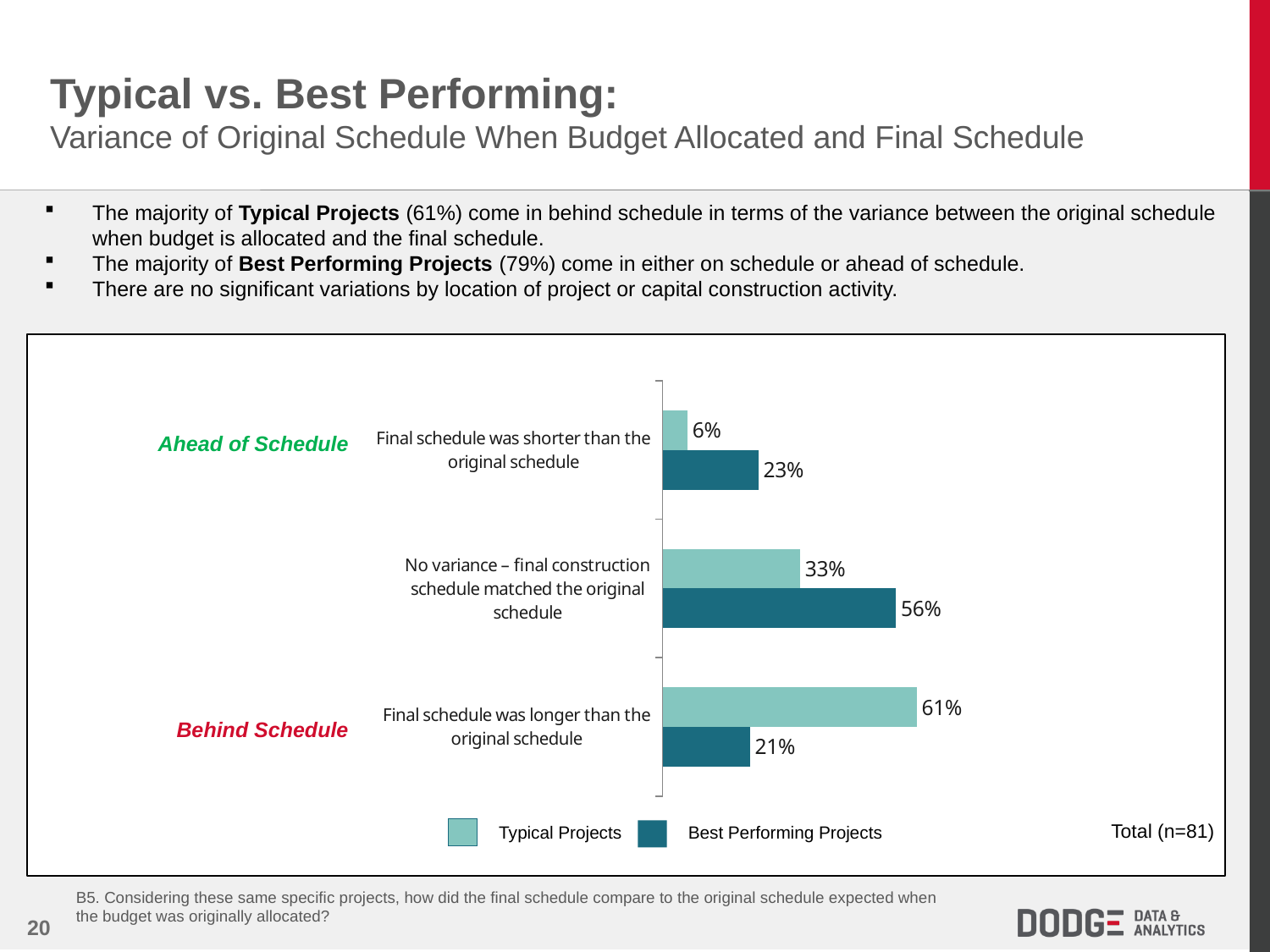
What percentage of Typical Projects had a final schedule shorter than the original schedule? 6% Which category has the lowest value for Best Performing Projects? Final schedule was longer than the original schedule How many categories are shown in the chart? 3 What is the sample size shown next to the legend? Total (n=81) What kind of chart is shown on the slide? Bar chart For 'No variance – final construction schedule matched the original schedule', which series has the larger value, Typical Projects or Best Performing Projects? Best Performing Projects What is the difference between Typical Projects and Best Performing Projects for 'Final schedule was longer than the original schedule'? 40% Which category has the highest value for Typical Projects? Final schedule was longer than the original schedule How many series does the legend list? 2 What percentage of Best Performing Projects had no variance between the final and original schedule? 56% What percentage of Best Performing Projects had a final schedule longer than the original schedule? 21% What percentage of Typical Projects had a final schedule longer than the original schedule? 61%